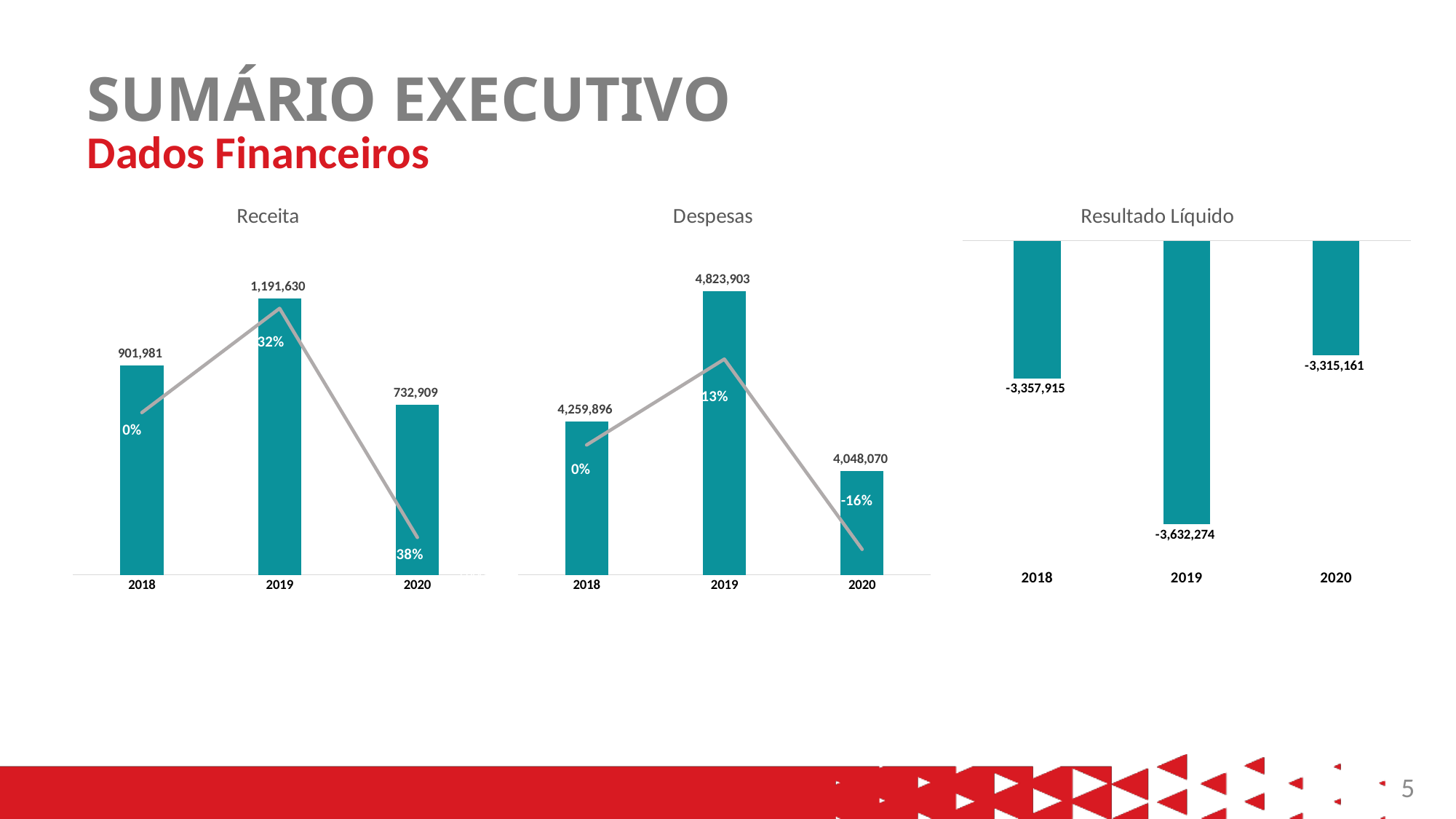
In the Resultado Líquido chart, which year has the lowest value? 2019 In the Resultado Líquido chart, is the value for 2018 larger or smaller than the value for 2019? larger In the Receita chart, what is the difference between the 2019 and 2018 values? 289,649 In the Despesas chart, which year has the highest value? 2019 In the Receita chart, which year has the lowest value? 2020 In the Receita chart, what percentage label is shown on the 2019 bar? 32% In the Despesas chart, what is the value for 2020? 4,048,070 In the Despesas chart, what is the difference between the 2019 and 2020 values? 775,833 How many charts are shown on the slide? 3 In the Resultado Líquido chart, what is the value for 2019? -3,632,274 In the Receita chart, what is the value for 2019? 1,191,630 In the Despesas chart, what percentage label is shown on the 2020 bar? -16%